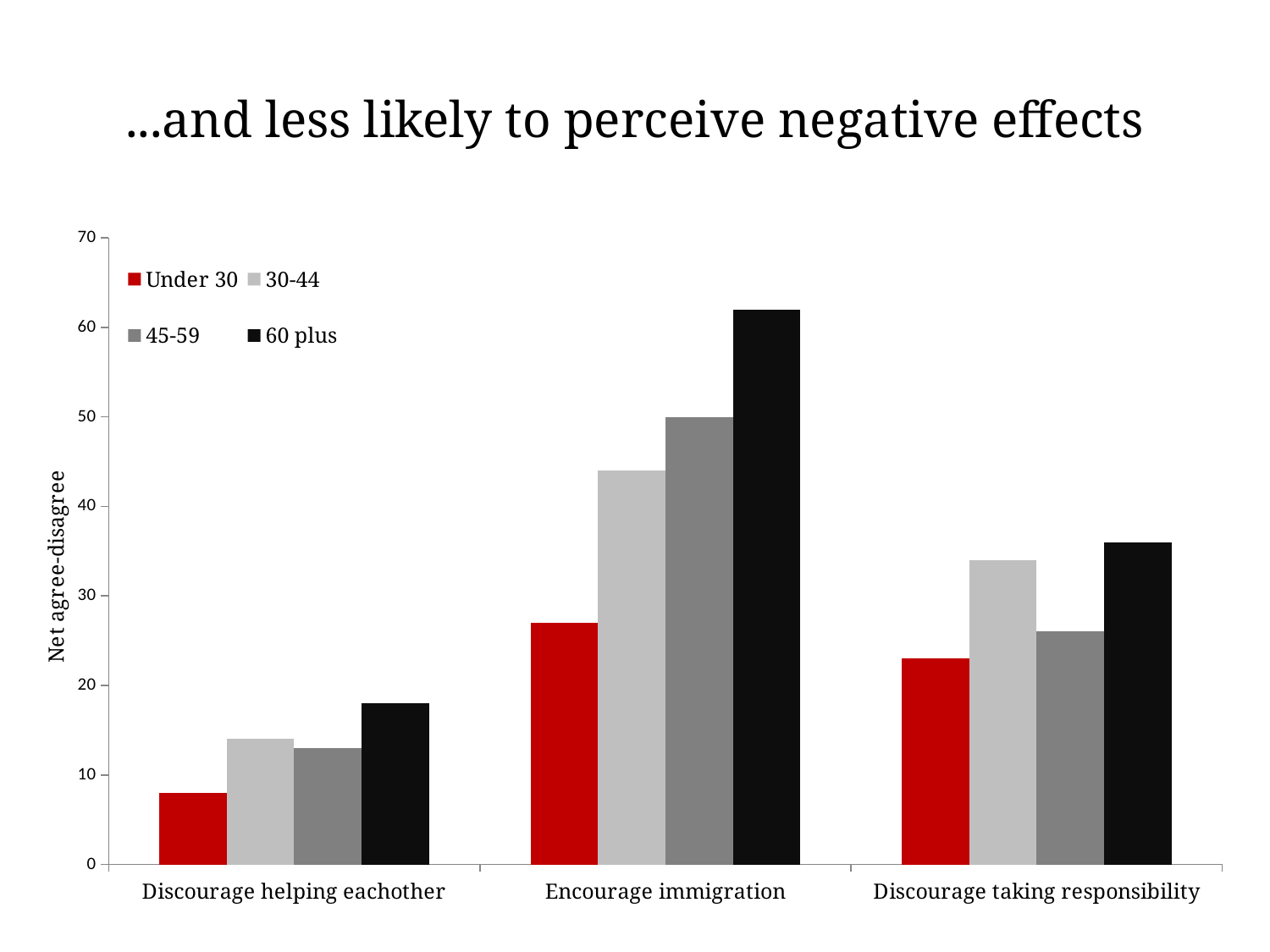
How many categories are shown on the x axis? 3 Which age group has the lowest value for Discourage helping eachother? Under 30 Is the value for 60 plus in Encourage immigration greater or less than 60? greater What kind of chart is shown on the slide? bar chart For Discourage taking responsibility, which is larger: the value for 30-44 or the value for 45-59? 30-44 What is the label on the vertical axis? Net agree-disagree Which age group has the highest value for Encourage immigration? 60 plus What is the title of the slide? ...and less likely to perceive negative effects Is the value for 30-44 in Encourage immigration greater or less than 40? greater Is the value for Under 30 in Discourage helping eachother greater or less than 10? less How many series does the legend list? 4 Which age group has the lowest value for Discourage taking responsibility? Under 30